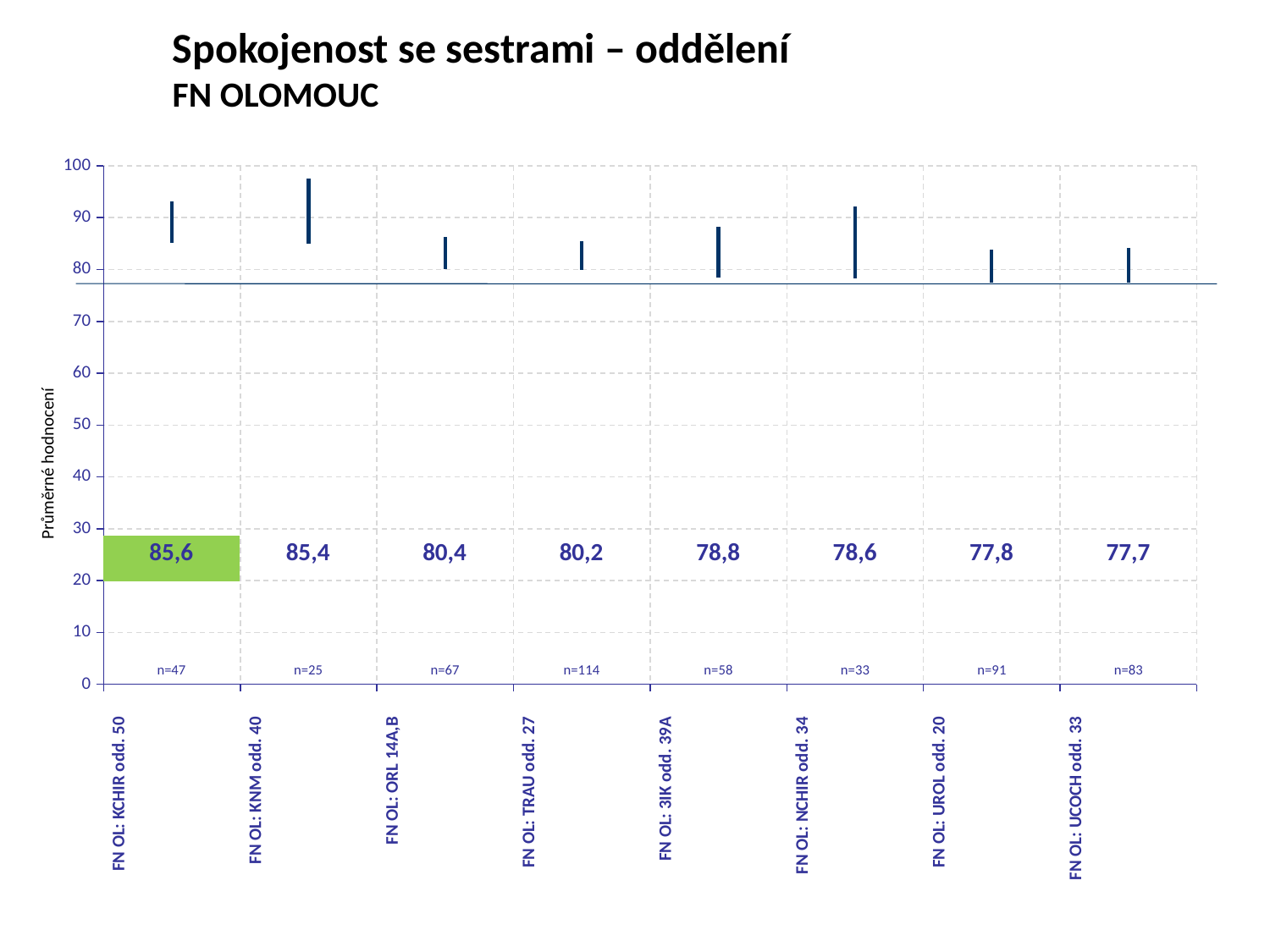
What is the average rating (průměrné hodnocení) for FN OL: KCHIR odd. 50? 85,6 What is the average rating for FN OL: TRAU odd. 27? 80,2 How many departments are shown on the chart? 8 Which department has the highest average rating? FN OL: KCHIR odd. 50 What is the label of the vertical axis? Průměrné hodnocení Which department has the lowest average rating? FN OL: UCOCH odd. 33 What is the average rating for FN OL: UCOCH odd. 33? 77,7 Which has a higher average rating, FN OL: ORL 14A,B or FN OL: 3IK odd. 39A? FN OL: ORL 14A,B What is the number of respondents (n) for FN OL: TRAU odd. 27? n=114 What is the number of respondents (n) for FN OL: KNM odd. 40? n=25 Do the average ratings rise or fall from left to right across the departments? fall What is the difference between the average ratings of FN OL: KCHIR odd. 50 and FN OL: UCOCH odd. 33? 7,9